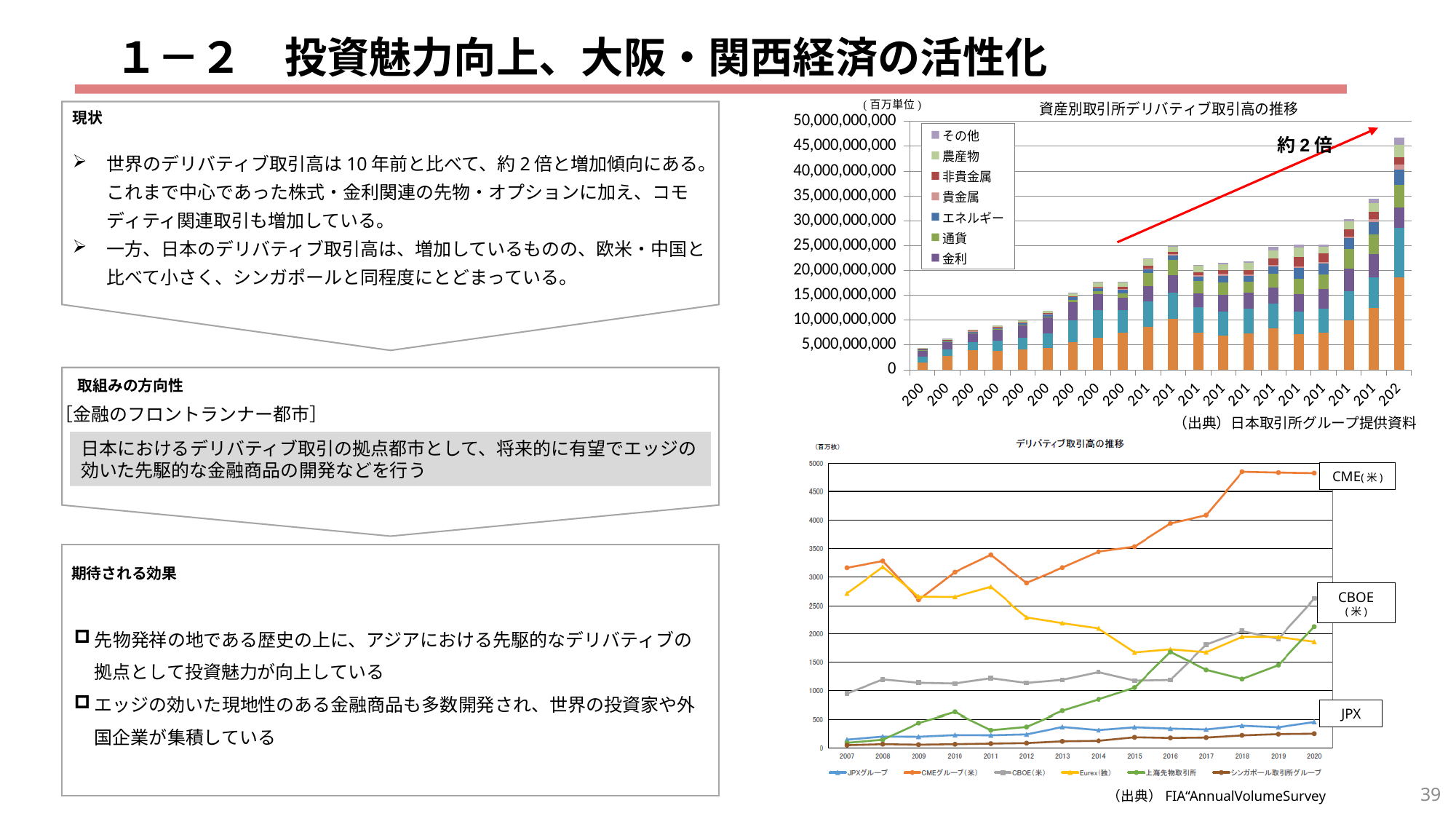
In the bottom chart (デリバティブ取引高の推移), does the CMEグループ(米) line generally rise or fall from 2007 to 2020? Rise In the bottom chart (デリバティブ取引高の推移), how many series does the legend list? 6 In the bottom chart (デリバティブ取引高の推移), how many years are shown on the x axis? 14 In the bottom chart (デリバティブ取引高の推移), which series has the highest value in 2020? CMEグループ(米) In the bottom chart (デリバティブ取引高の推移), which is larger in 2020, CBOE(米) or 上海先物取引所? CBOE(米) In the top chart (資産別取引所デリバティブ取引高の推移), is the total of the last (rightmost) bar greater or less than 45,000,000,000? greater In the bottom chart (デリバティブ取引高の推移), is the value for JPXグループ in 2020 greater or less than 1000? less In the bottom chart (デリバティブ取引高の推移), is the value for CMEグループ(米) in 2020 greater or less than 4500? greater In the bottom chart (デリバティブ取引高の推移), which series has the lowest value in 2020? シンガポール取引所グループ In the top chart (資産別取引所デリバティブ取引高の推移), which legend entry is listed first at the top of the legend? その他 What kind of chart is the bottom chart titled デリバティブ取引高の推移? Line chart What kind of chart is the top chart titled 資産別取引所デリバティブ取引高の推移? Stacked bar chart